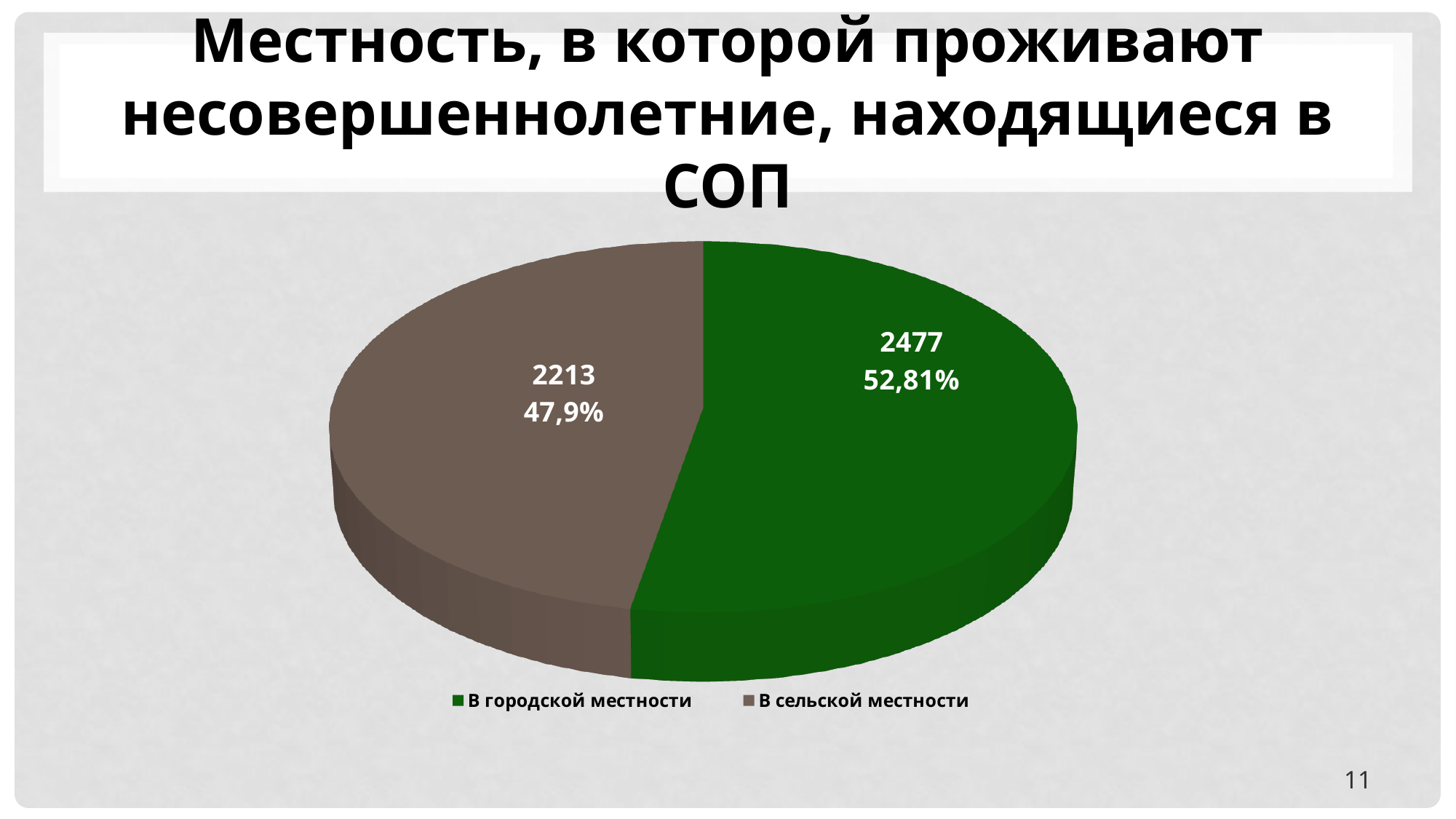
What is the total of the two values shown on the pie chart? 4690 What colour is the slice for «В сельской местности»? Brown What is the difference between the values for «В городской местности» and «В сельской местности»? 264 Which category has the smallest slice? В сельской местности How many slices does the pie chart have? 2 What is the value for «В городской местности»? 2477 What percentage share is shown for «В городской местности»? 52,81% What kind of chart is shown on the slide? Pie chart Which is larger: the value for «В городской местности» or «В сельской местности»? В городской местности What is the value for «В сельской местности»? 2213 What percentage share is shown for «В сельской местности»? 47,9% Which category has the largest slice? В городской местности